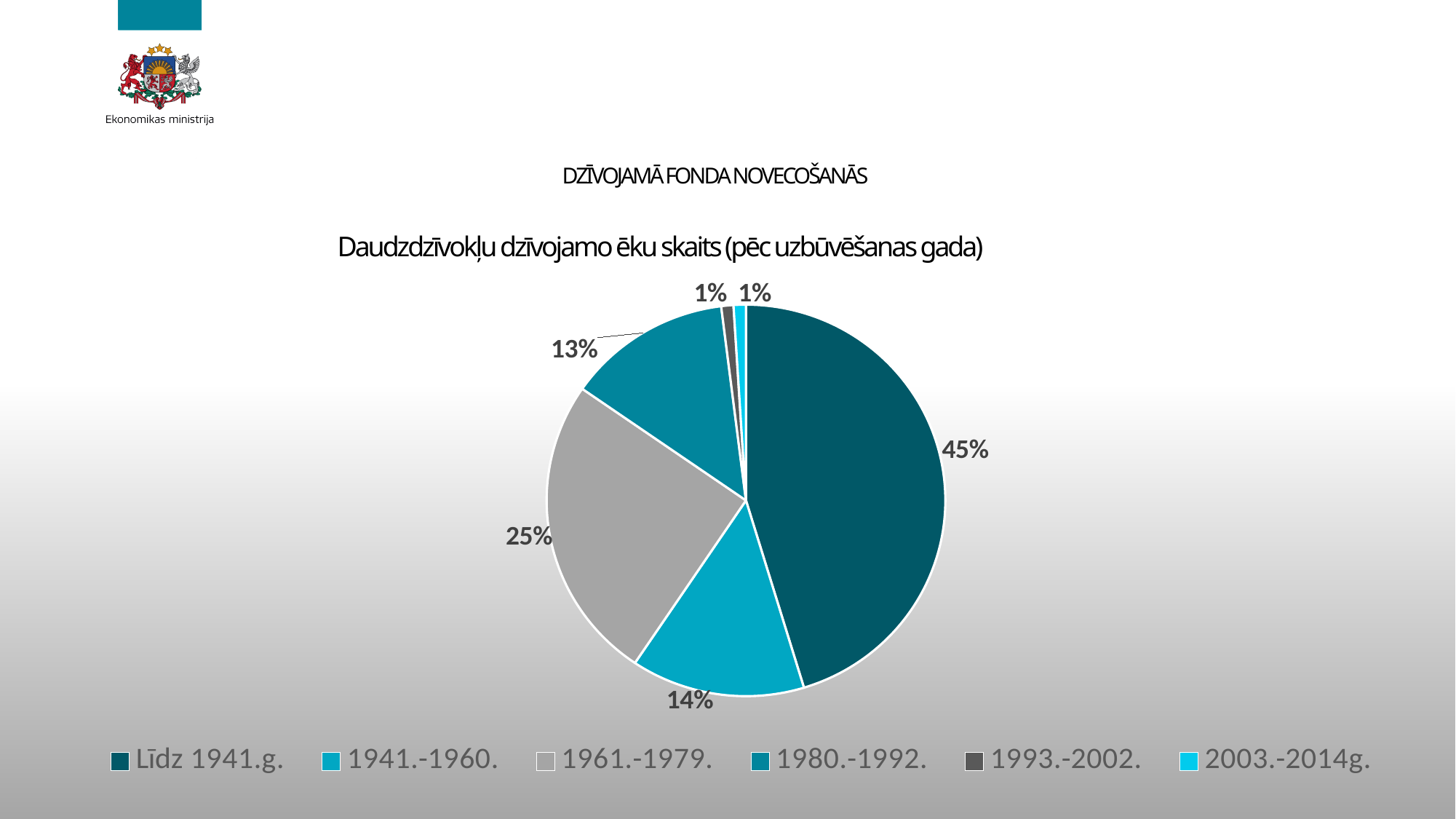
What share of the pie does the '1980.-1992.' slice represent? 13% What is the combined share of the '1993.-2002.' and '2003.-2014g.' slices? 2% What share of the pie does the 'Līdz 1941.g.' slice represent? 45% Which slice is larger, '1941.-1960.' or '1961.-1979.'? 1961.-1979. What share of the pie does the '1961.-1979.' slice represent? 25% How many categories does the legend list? 6 What kind of chart is shown on the slide? pie chart What is the title of the chart? Daudzdzīvokļu dzīvojamo ēku skaits (pēc uzbūvēšanas gada) Which category has the largest slice of the pie? Līdz 1941.g. What is the difference in percentage points between the 'Līdz 1941.g.' slice and the '1961.-1979.' slice? 20